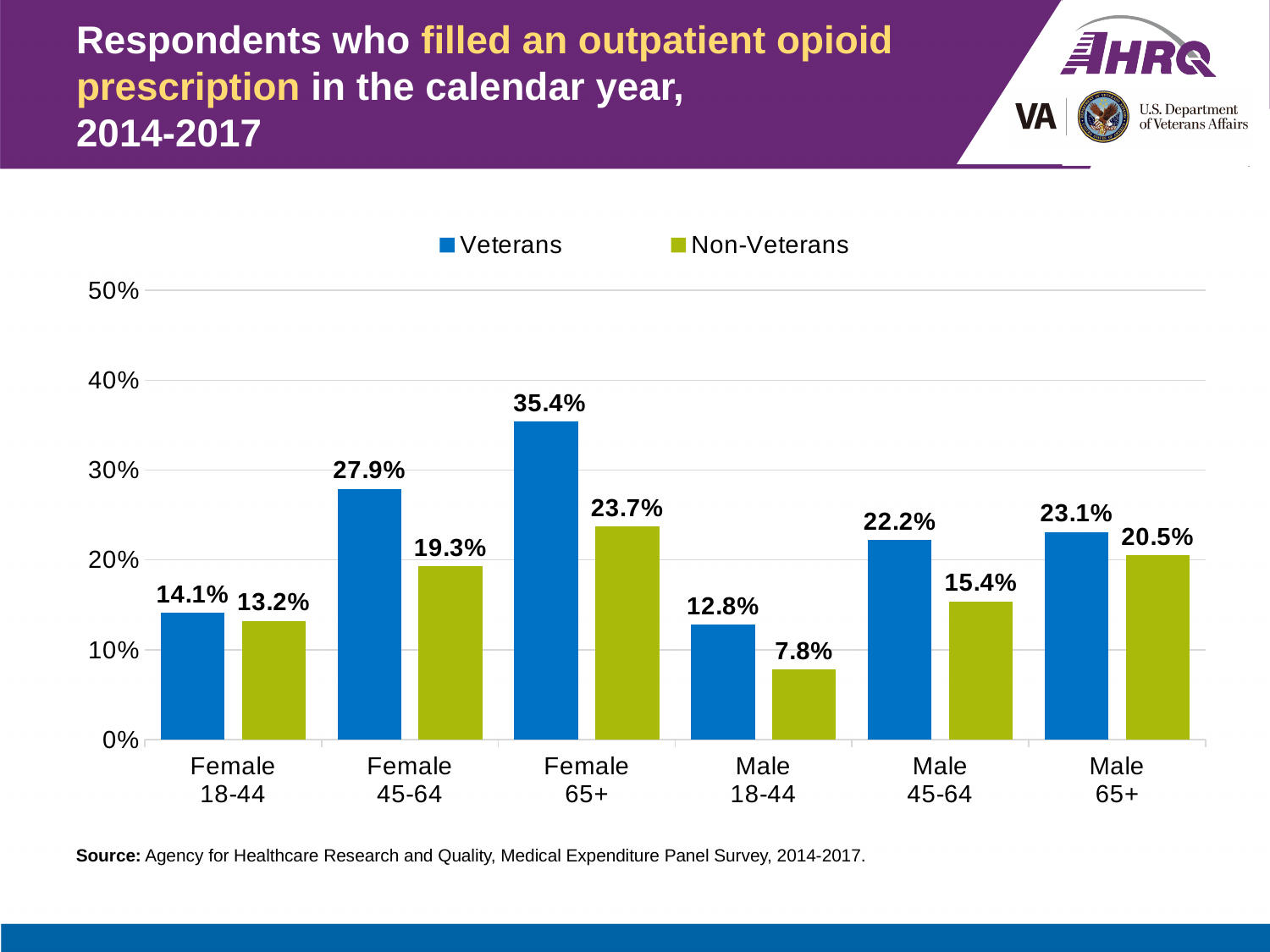
What percentage of Veterans aged Female 65+ filled an outpatient opioid prescription? 35.4% What is the value for Veterans in the Male 45-64 group? 22.2% What kind of chart is shown on the slide? Bar chart Which is larger in the Male 65+ group: Veterans or Non-Veterans? Veterans Which colour represents Non-Veterans in the chart? Green Which category has the lowest value for Non-Veterans? Male 18-44 How many categories are shown on the x axis? 6 Which category has the highest value for Veterans? Female 65+ Is the value for Non-Veterans in the Female 45-64 group greater or less than 20%? less What is the value for Non-Veterans in the Male 18-44 group? 7.8% How many series does the legend list? 2 What is the difference between Veterans and Non-Veterans in the Female 65+ group? 11.7%